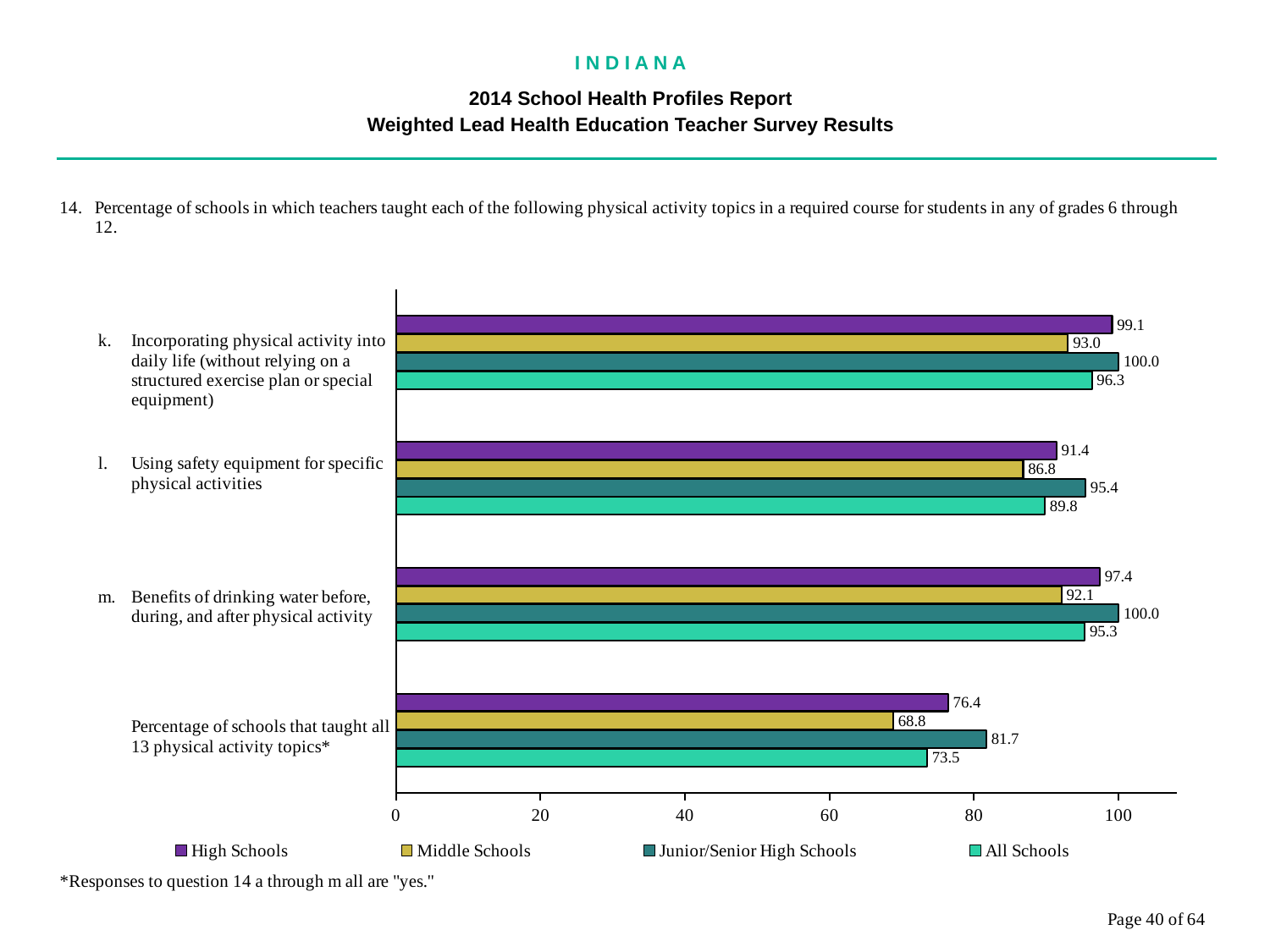
Which series is shown in purple in the legend? High Schools How many topic categories are shown on the chart? 4 What is the value for All Schools for 'Benefits of drinking water before, during, and after physical activity'? 95.3 Which is larger for 'Benefits of drinking water before, during, and after physical activity': the High Schools value or the Middle Schools value? High Schools Is the All Schools value for 'Percentage of schools that taught all 13 physical activity topics*' greater or less than 80? less What kind of chart is shown on the slide? bar chart What is the value for Middle Schools for 'Percentage of schools that taught all 13 physical activity topics*'? 68.8 Which school type has the highest value for 'Incorporating physical activity into daily life (without relying on a structured exercise plan or special equipment)'? Junior/Senior High Schools What is the value for High Schools for 'Using safety equipment for specific physical activities'? 91.4 How many series does the legend list? 4 Which school type has the lowest value for 'Using safety equipment for specific physical activities'? Middle Schools What is the difference between the Junior/Senior High Schools and Middle Schools values for 'Percentage of schools that taught all 13 physical activity topics*'? 12.9